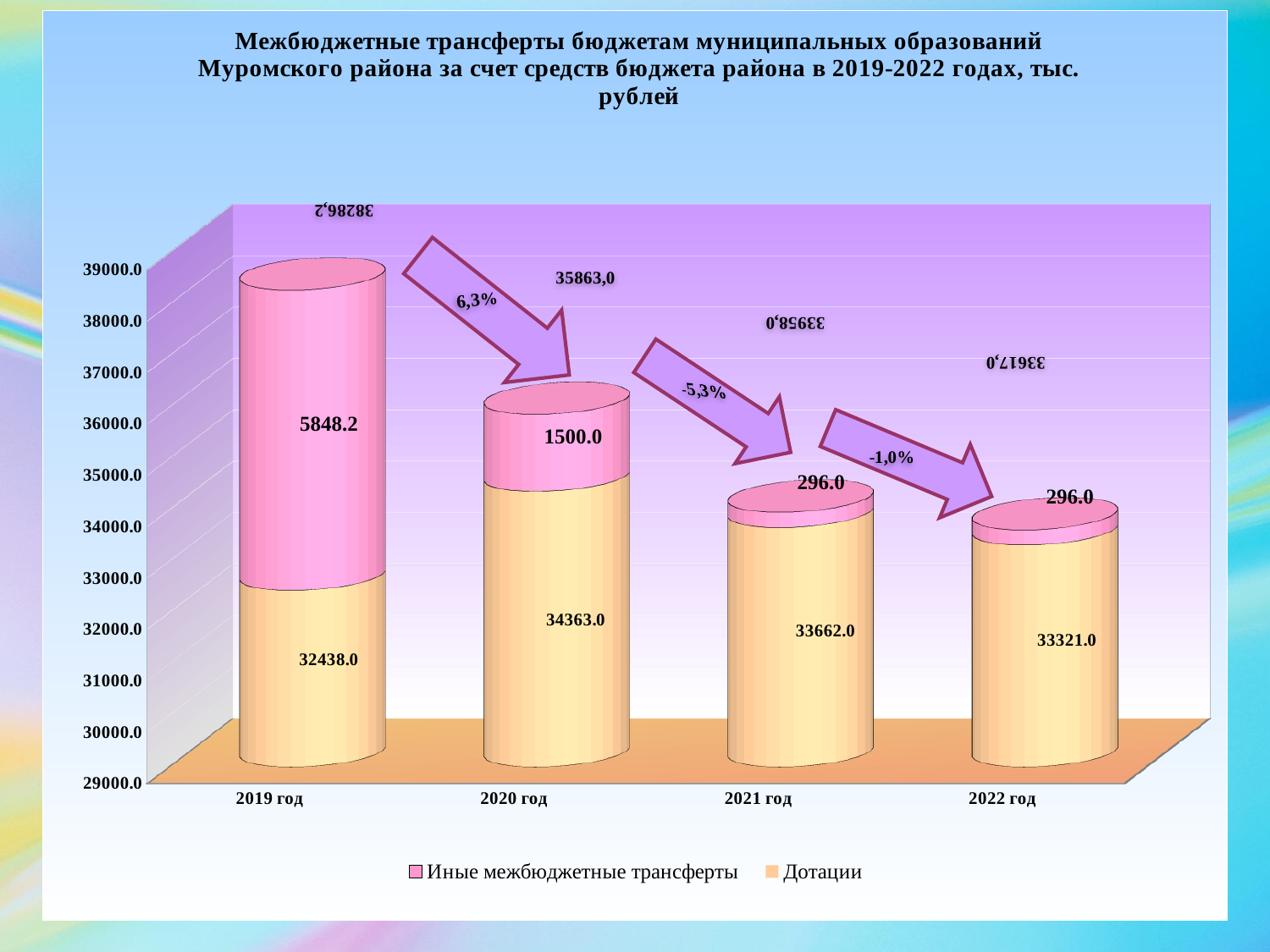
What is the value of Дотации for 2022 год? 33321.0 How many years (categories) are shown on the x axis? 4 What is the difference between Дотации in 2020 год and 2021 год? 701.0 In which year is the value of Иные межбюджетные трансферты highest? 2019 год In which year is the value of Дотации lowest? 2019 год Does the value of Иные межбюджетные трансферты rise or fall from 2019 год to 2022 год? Fall What type of chart is shown on the slide? Stacked bar chart Which is larger: Дотации in 2021 год or Дотации in 2022 год? 2021 год What is the value of Иные межбюджетные трансферты for 2020 год? 1500.0 What is the value of Дотации for 2019 год? 32438.0 What is the total of the stacked bar for 2020 год? 35863.0 How many series does the legend list? 2